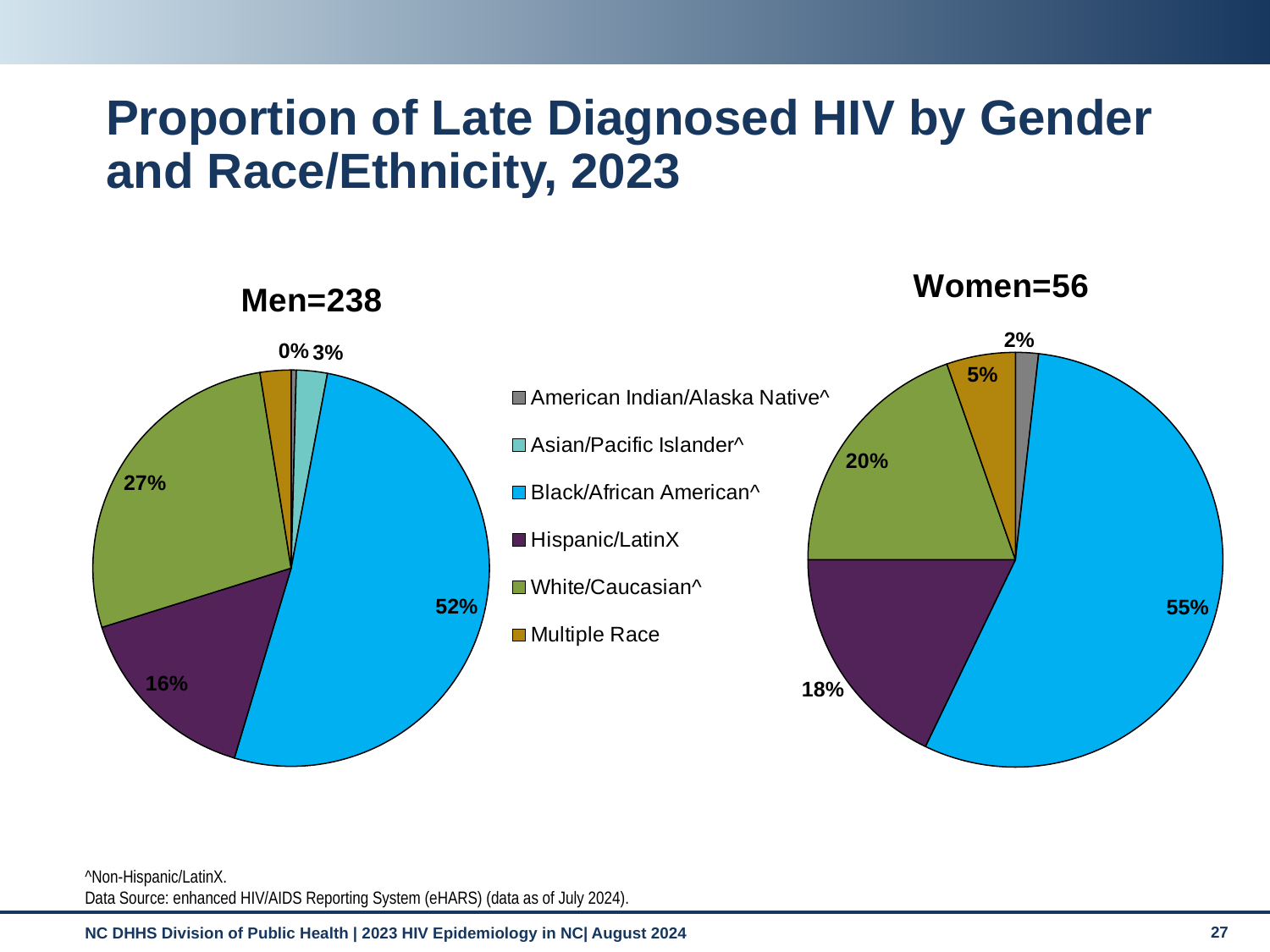
In the Men=238 pie chart, what percentage is White/Caucasian^? 27% What type of chart is used on this slide? Pie chart How many race/ethnicity categories does the legend list? 6 In the Women=56 pie chart, what percentage is Multiple Race? 5% Is the Hispanic/LatinX share larger in the Men=238 chart or the Women=56 chart? Women=56 In the Men=238 pie chart, what percentage is Asian/Pacific Islander^? 3% In the Women=56 pie chart, which race/ethnicity has the largest share? Black/African American^ In the Men=238 pie chart, what percentage is Black/African American^? 52% In the Men=238 pie chart, which labeled race/ethnicity has the smallest share? American Indian/Alaska Native^ In the Women=56 pie chart, what percentage is Black/African American^? 55% In the Women=56 pie chart, what percentage is Hispanic/LatinX? 18% What is the difference between the White/Caucasian^ share in the Men=238 chart and the White/Caucasian^ share in the Women=56 chart? 7%